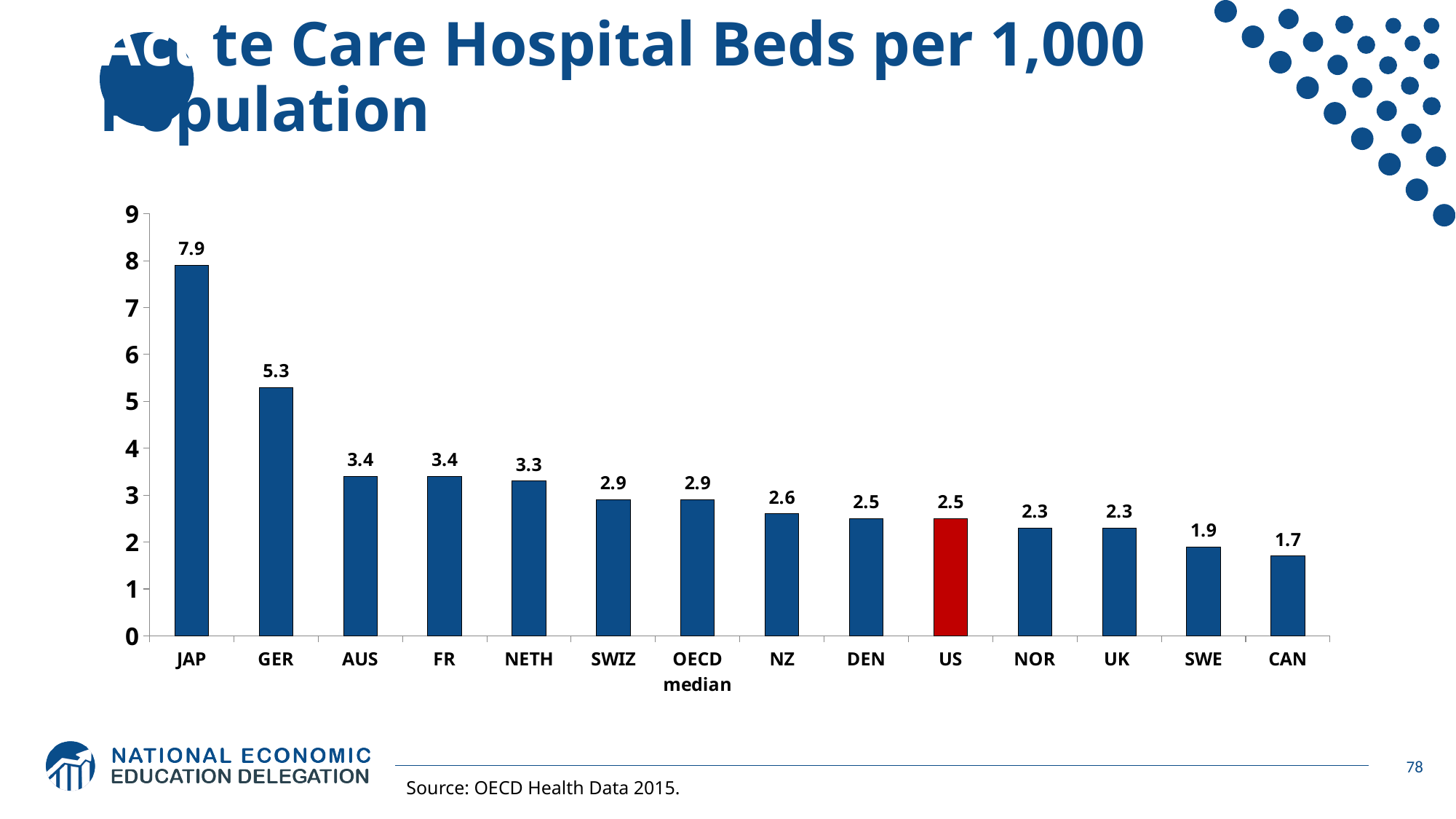
What is the difference between the values for JAP and GER? 2.6 What is the value for the US? 2.5 What kind of chart is shown on the slide? Bar chart How many categories are shown on the x axis? 14 What is the value for the OECD median? 2.9 What is the difference between the OECD median and the US value? 0.4 Which is larger, the value for NETH or the value for SWIZ? NETH Which country has the lowest number of acute care hospital beds per 1,000 population? CAN What is the value for JAP? 7.9 Which country has the highest number of acute care hospital beds per 1,000 population? JAP Is the value for GER greater or less than 5? greater Which bar is coloured red instead of blue? US